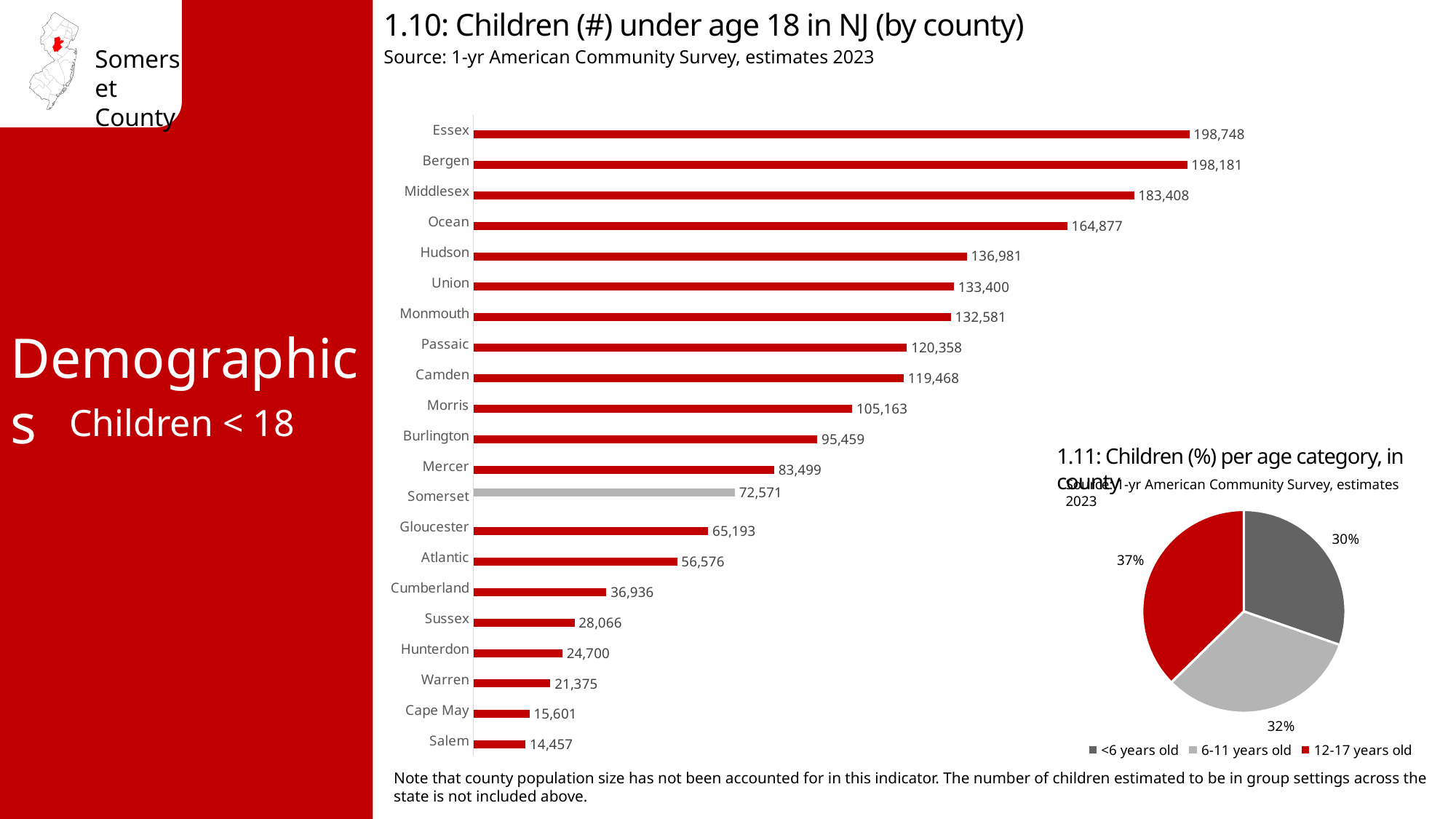
In chart 1.10, which county has the lowest number of children under 18? Salem In chart 1.11, which age category has the largest share? 12-17 years old In chart 1.11, what share of children are 6-11 years old? 32% What type of chart is chart 1.10? Bar chart In chart 1.10, which county's bar is shown in grey instead of red? Somerset How many categories does the legend of chart 1.11 list? 3 In chart 1.10, what is the value for Hudson? 136,981 In chart 1.10, which county has the highest number of children under 18? Essex In chart 1.10, which has more children under 18, Passaic or Camden? Passaic In chart 1.10, how many counties are shown? 21 In chart 1.10, how many children under age 18 are in Somerset County? 72,571 In chart 1.10, what is the difference between Mercer and Somerset? 10,928